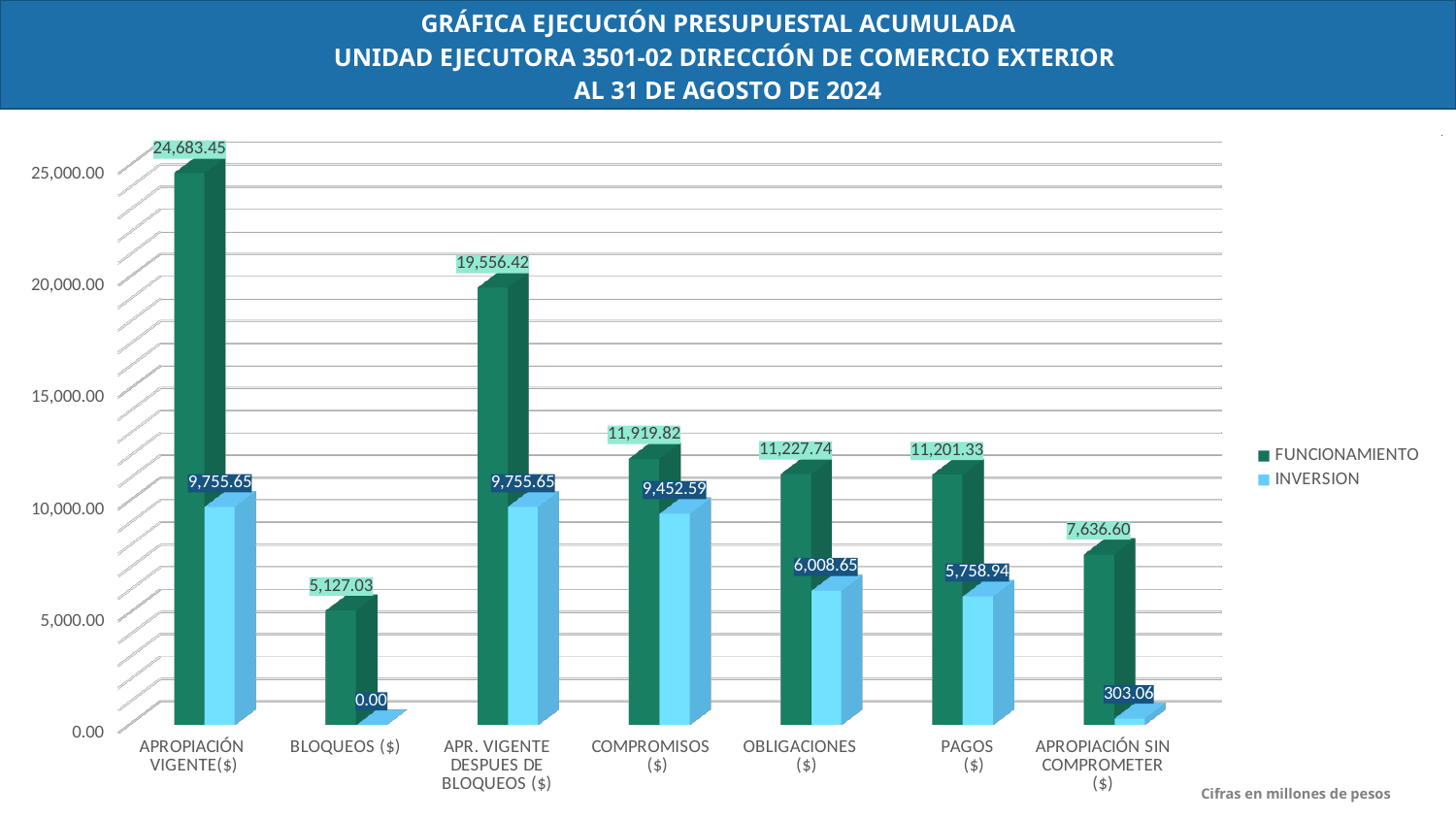
Which category has the lowest INVERSION value? BLOQUEOS ($) What is the INVERSION value for COMPROMISOS ($)? 9,452.59 How many series does the legend list? 2 Which category has the highest FUNCIONAMIENTO value? APROPIACIÓN VIGENTE($) Which is larger for APROPIACIÓN SIN COMPROMETER ($): FUNCIONAMIENTO or INVERSION? FUNCIONAMIENTO What is the INVERSION value for BLOQUEOS ($)? 0.00 What is the FUNCIONAMIENTO value for PAGOS ($)? 11,201.33 How many categories are shown on the x axis? 7 What kind of chart is shown on the slide? Bar chart What is the difference between the FUNCIONAMIENTO and INVERSION values for OBLIGACIONES ($)? 5,219.09 What is the FUNCIONAMIENTO value for APROPIACIÓN VIGENTE($)? 24,683.45 What is the difference between the FUNCIONAMIENTO values for APROPIACIÓN VIGENTE($) and APR. VIGENTE DESPUES DE BLOQUEOS ($)? 5,127.03